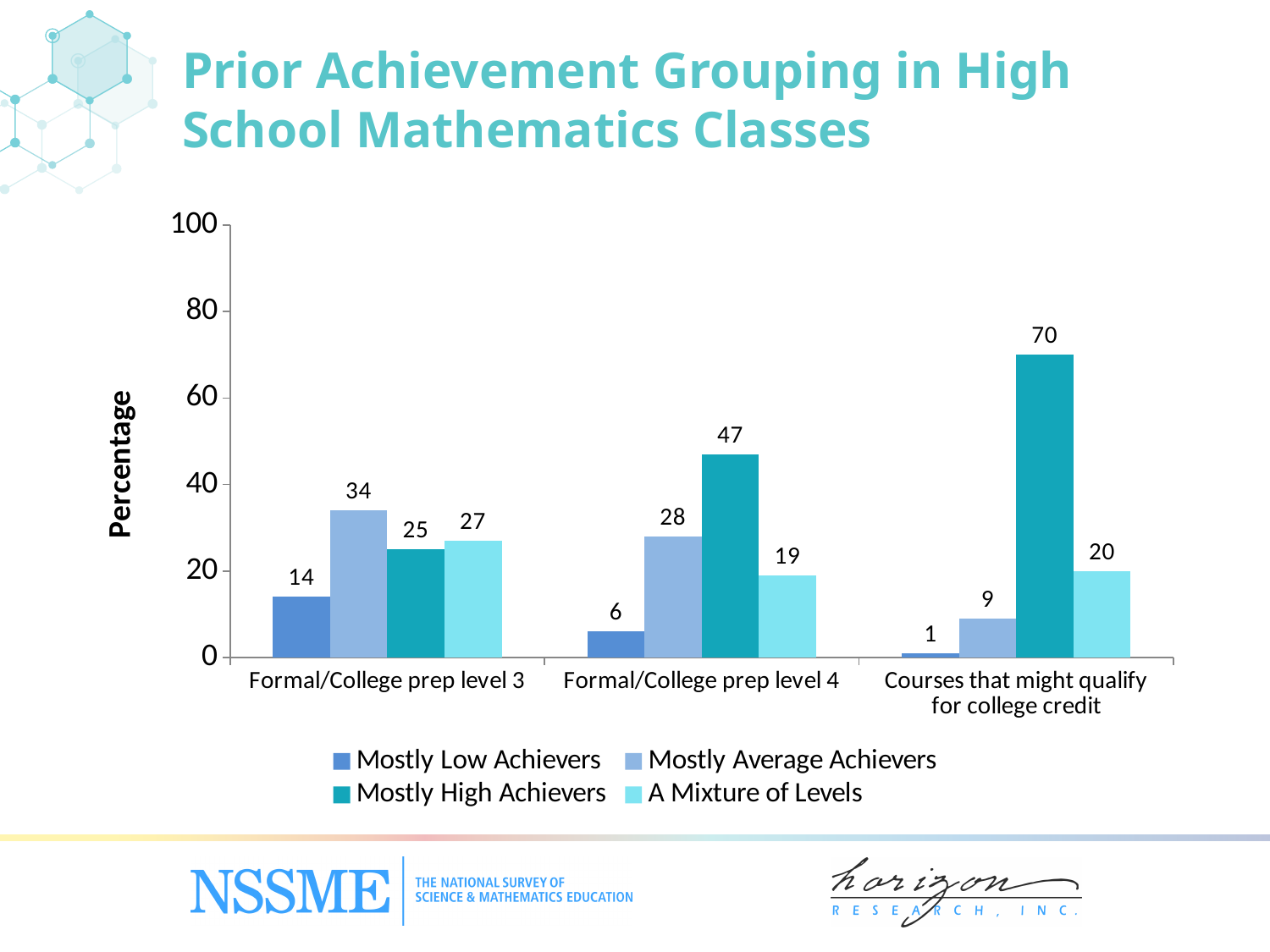
What percentage of Formal/College prep level 4 classes are A Mixture of Levels? 19 What percentage of Courses that might qualify for college credit are Mostly High Achievers? 70 How many series does the legend list? 4 What kind of chart is shown on the slide? Bar chart What is the label of the y axis? Percentage How many course categories are shown on the x axis? 3 Is the Mostly Average Achievers value for Formal/College prep level 4 greater or less than 20? greater Which category has the lowest percentage of Mostly High Achievers? Formal/College prep level 3 What is the difference between the Mostly High Achievers percentage for Courses that might qualify for college credit and for Formal/College prep level 4? 23 What percentage of Formal/College prep level 3 classes are Mostly Average Achievers? 34 Which is larger for Formal/College prep level 3: Mostly High Achievers or A Mixture of Levels? A Mixture of Levels Which category has the highest percentage of Mostly Low Achievers? Formal/College prep level 3